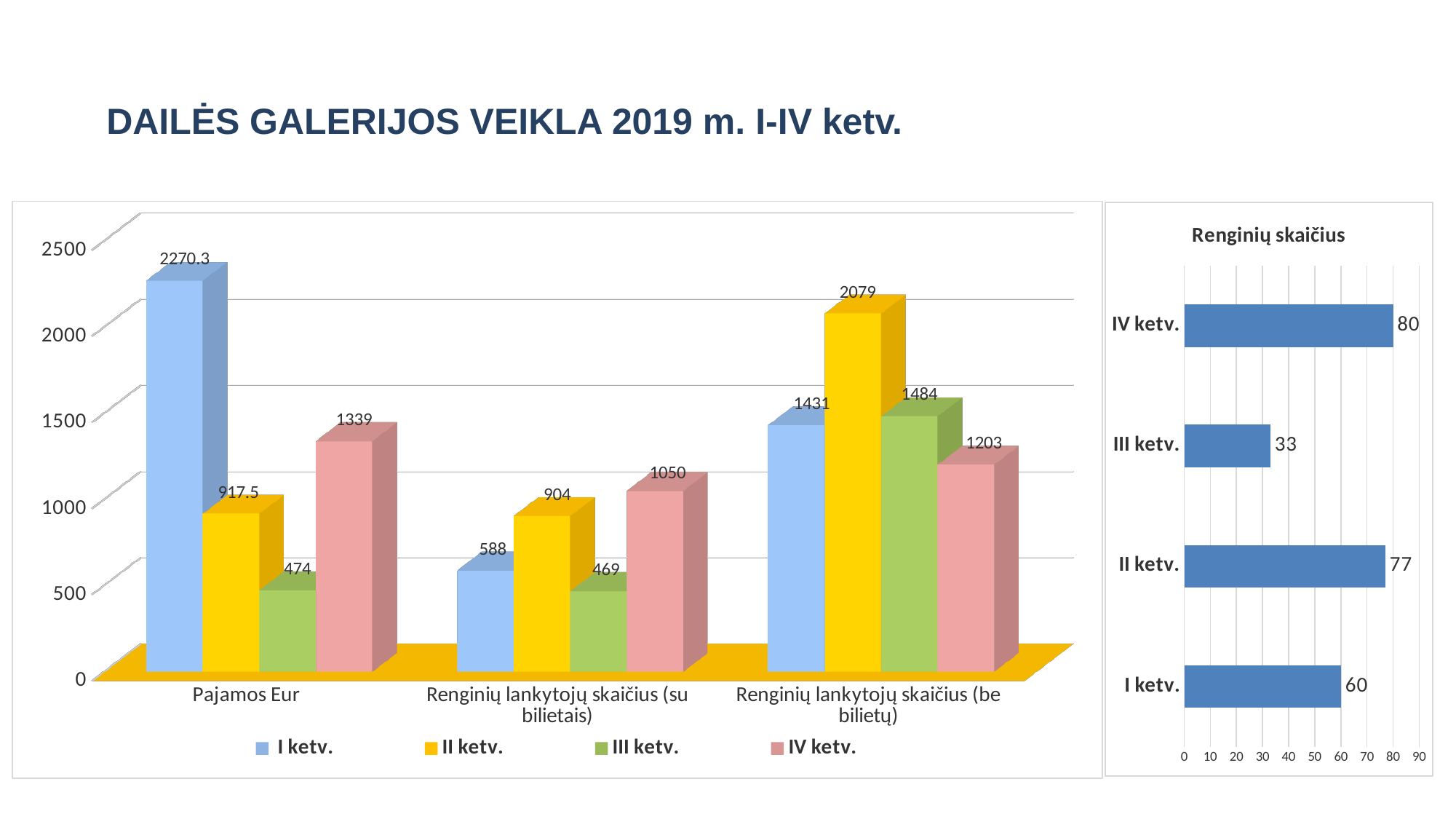
In the left chart, which is larger: the IV ketv. value for Pajamos Eur or the IV ketv. value for Renginių lankytojų skaičius (be bilietų)? Pajamos Eur How many series does the legend of the left chart list? 4 In the Renginių skaičius chart, what is the value for III ketv.? 33 In the Renginių skaičius chart, what is the difference between the II ketv. and I ketv. values? 17 In the left chart, which series has the highest value in the Renginių lankytojų skaičius (be bilietų) category? II ketv. What kind of chart is the Renginių skaičius chart? Bar chart In the left chart, what is the value for IV ketv. in the Renginių lankytojų skaičius (su bilietais) category? 1050 In the left chart, what is the difference between the II ketv. and I ketv. values in the Renginių lankytojų skaičius (be bilietų) category? 648 How many categories are shown on the x axis of the left chart? 3 In the left chart, what is the value for I ketv. in the Pajamos Eur category? 2270.3 In the left chart, which series has the lowest value in the Pajamos Eur category? III ketv. In the Renginių skaičius chart, which quarter has the highest value? IV ketv.